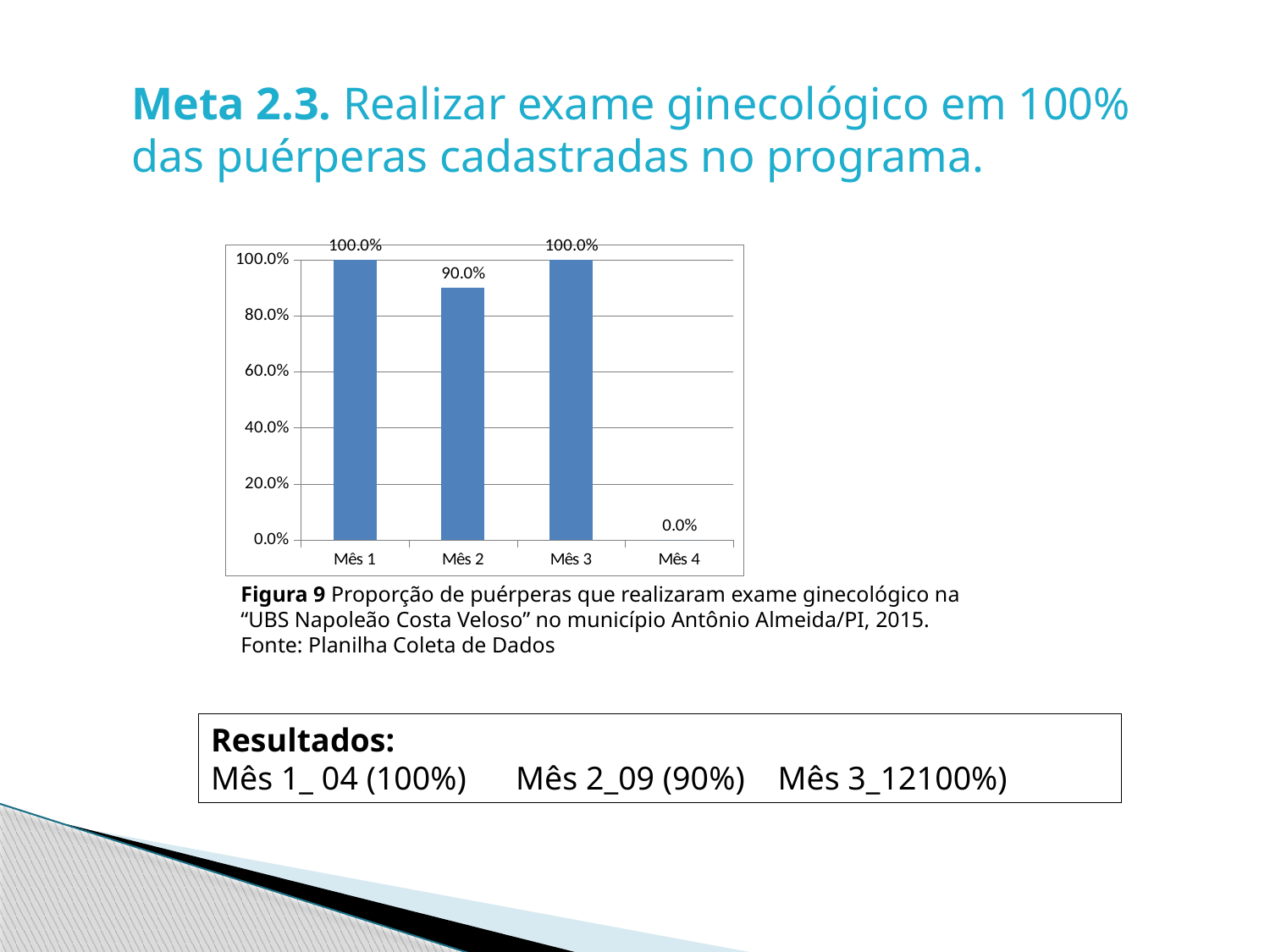
What is the value for Mês 2? 90.0% What is the value for Mês 1? 100.0% What colour are the bars in the chart? blue How many months have a value of 100.0%? 2 What kind of chart is shown on the slide? bar chart Which month has the lowest value? Mês 4 Is the value for Mês 2 greater or less than 80.0%? greater What is the difference between the values for Mês 1 and Mês 2? 10.0% What is the figure number given in the caption below the chart? Figura 9 Which is larger, the value for Mês 2 or the value for Mês 3? Mês 3 What is the value for Mês 4? 0.0% How many months are shown on the x axis? 4